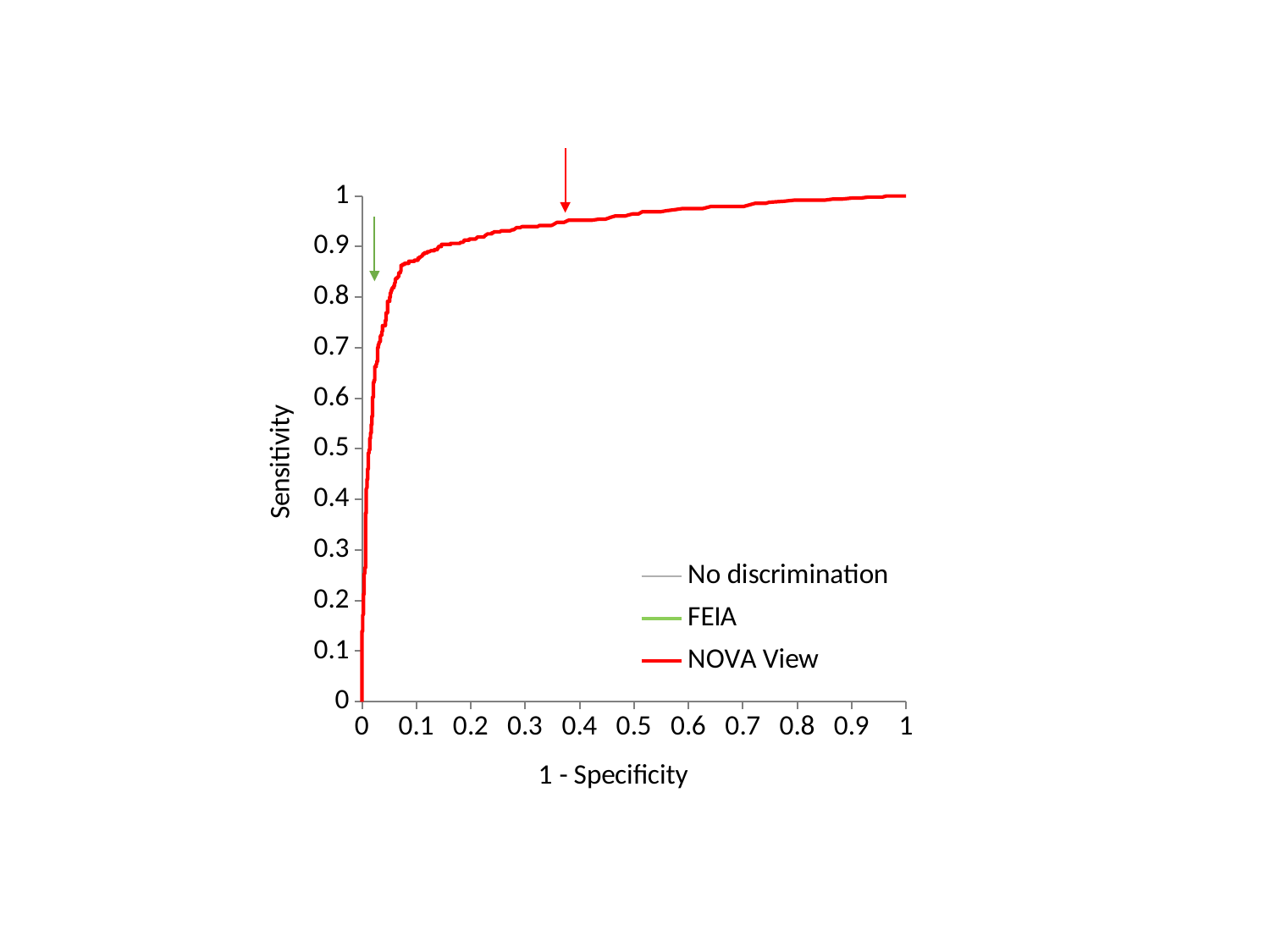
What kind of chart is shown on the slide? line chart Is the NOVA View sensitivity at 1 - Specificity of 0.5 greater or less than 0.9? greater What is the label of the x axis? 1 - Specificity What is the label of the y axis? Sensitivity Is the NOVA View sensitivity at 1 - Specificity of 0.1 greater or less than 0.8? greater Is the NOVA View sensitivity at 1 - Specificity of 0.3 greater or less than 1? less How many series does the legend list? 3 Does the NOVA View curve rise or fall as 1 - Specificity increases? rise What is the highest value shown on the y axis? 1